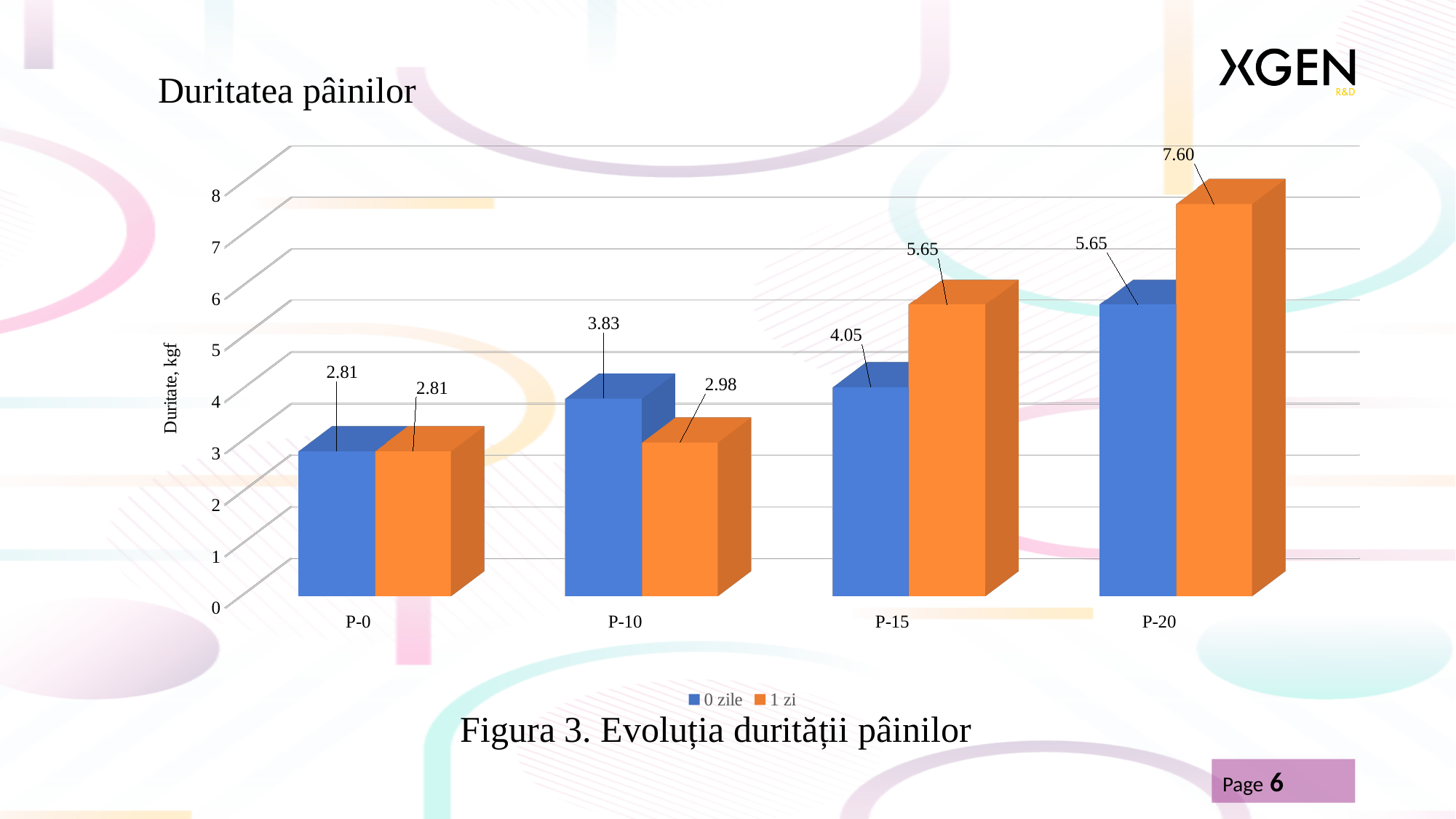
What is the difference between the "1 zi" and "0 zile" values for P-20? 1.95 How many categories are shown on the x axis? 4 What is the value for P-15 in the "1 zi" series? 5.65 What is the value for P-20 in the "1 zi" series? 7.60 What is the value for P-10 in the "0 zile" series? 3.83 Do the values in the "1 zi" series rise or fall from P-0 to P-20? Rise How many series does the legend list? 2 Which category has the lowest value in the "0 zile" series? P-0 What is the label of the vertical axis? Duritate, kgf Which category has the highest value in the "1 zi" series? P-20 What kind of chart is shown on the slide? Bar chart For P-10, which series has the larger value, "0 zile" or "1 zi"? 0 zile